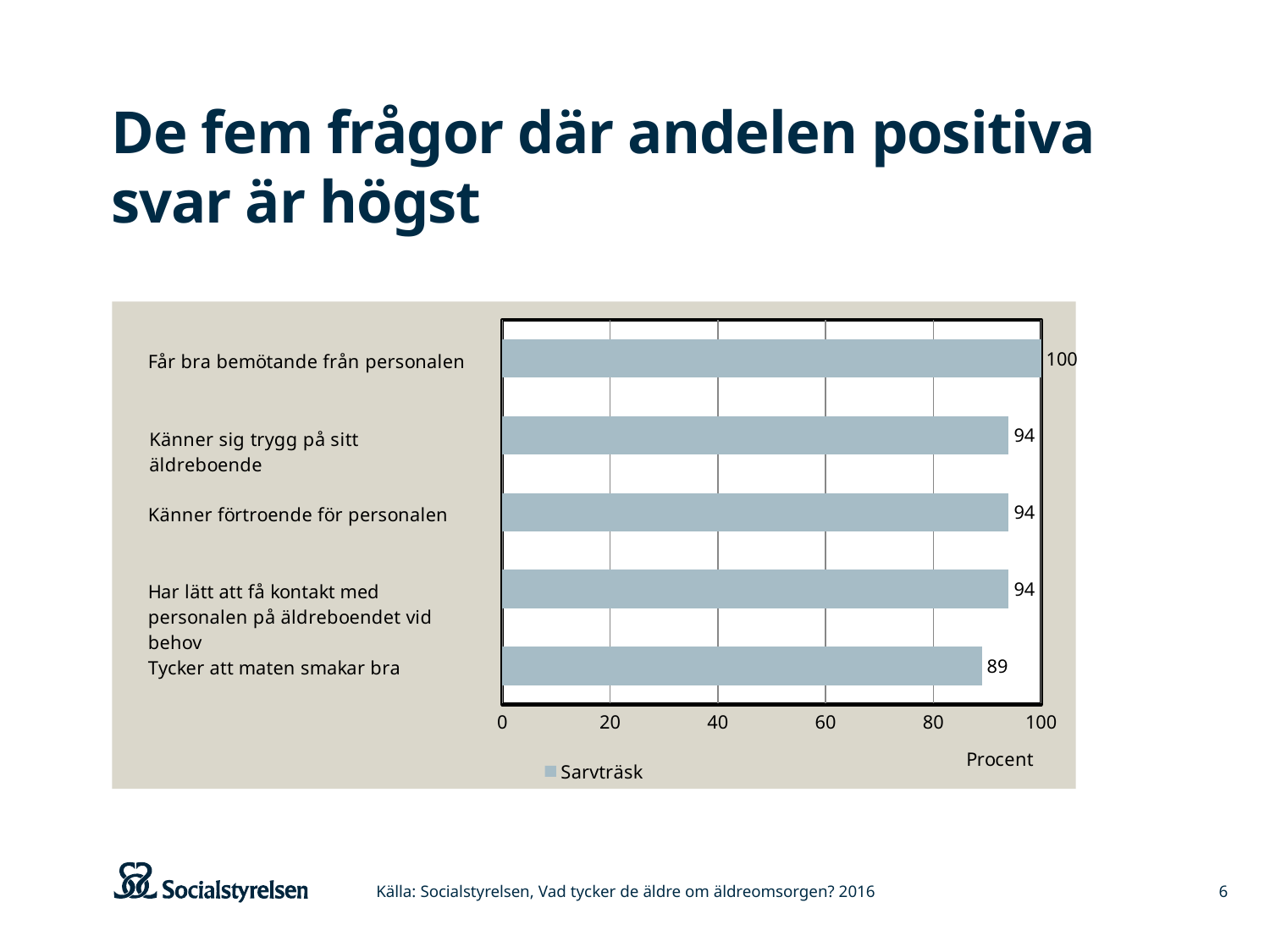
What is the value for "Tycker att maten smakar bra"? 89 Which is larger, the value for "Har lätt att få kontakt med personalen på äldreboendet vid behov" or the value for "Tycker att maten smakar bra"? Har lätt att få kontakt med personalen på äldreboendet vid behov What is the difference between the values for "Känner förtroende för personalen" and "Tycker att maten smakar bra"? 5 Which category has the lowest value? Tycker att maten smakar bra What is the difference between the values for "Får bra bemötande från personalen" and "Tycker att maten smakar bra"? 11 How many categories are shown in the chart? 5 Which category has the highest value? Får bra bemötande från personalen What kind of chart is shown on the slide? bar chart What is the value for "Känner sig trygg på sitt äldreboende"? 94 Is the value for "Tycker att maten smakar bra" greater or less than 80? greater How many series does the legend list? 1 What is the value for "Får bra bemötande från personalen"? 100